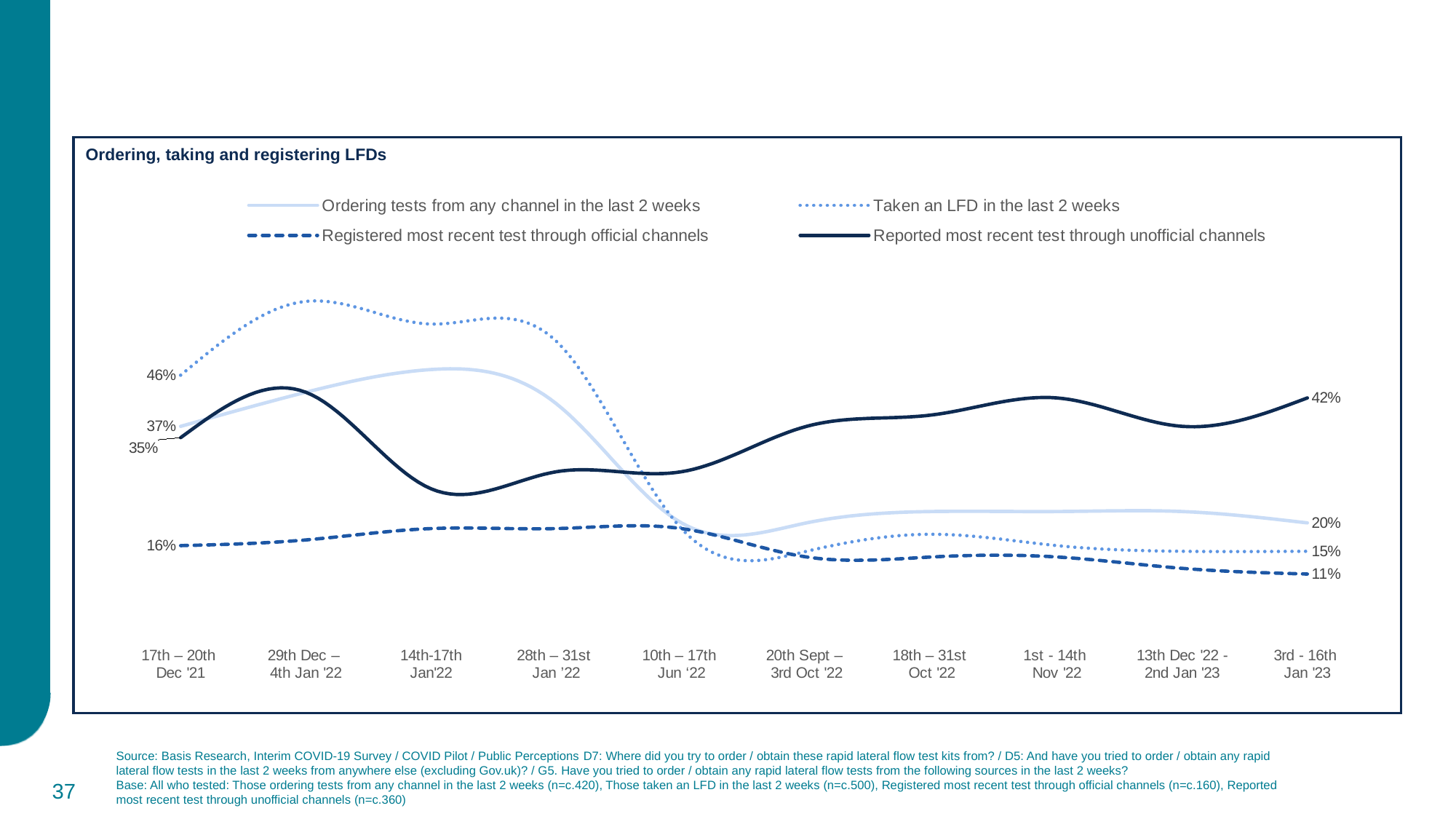
By how many percentage points did 'Taken an LFD in the last 2 weeks' fall between 17th – 20th Dec '21 and 3rd - 16th Jan '23? 31 percentage points What kind of chart is shown on the slide? Line chart What is the value for 'Ordering tests from any channel in the last 2 weeks' at 17th – 20th Dec '21? 37% Which series has the highest value at 3rd - 16th Jan '23? Reported most recent test through unofficial channels What is the title of the chart? Ordering, taking and registering LFDs At 3rd - 16th Jan '23, which is larger: 'Ordering tests from any channel in the last 2 weeks' or 'Taken an LFD in the last 2 weeks'? Ordering tests from any channel in the last 2 weeks Does 'Registered most recent test through official channels' rise or fall between 17th – 20th Dec '21 and 3rd - 16th Jan '23? Fall How many series does the legend list? 4 What is the value for 'Reported most recent test through unofficial channels' at 3rd - 16th Jan '23? 42% What is the value for 'Taken an LFD in the last 2 weeks' at 17th – 20th Dec '21? 46% How many time periods are shown on the x axis? 10 What is the value for 'Registered most recent test through official channels' at 3rd - 16th Jan '23? 11%